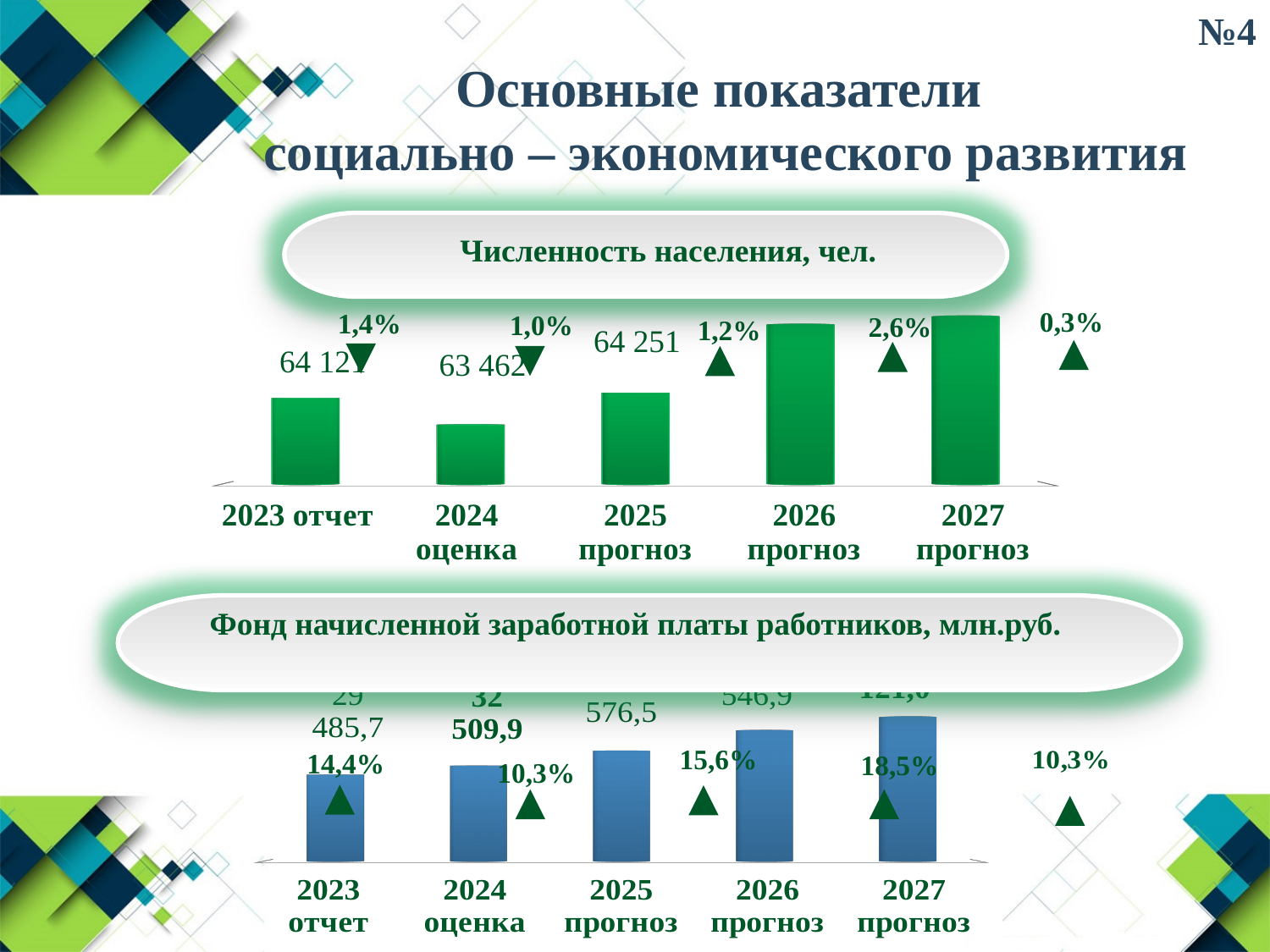
In the 'Фонд начисленной заработной платы работников, млн.руб.' chart, what is the difference between the values for 2024 оценка and 2023 отчет? 3 024,2 In the 'Численность населения, чел.' chart, which category has the highest bar? 2027 прогноз In the 'Фонд начисленной заработной платы работников, млн.руб.' chart, what percentage is printed above the 2027 прогноз bar? 10,3% In the 'Фонд начисленной заработной платы работников, млн.руб.' chart, what is the value for 2024 оценка? 32 509,9 In the 'Численность населения, чел.' chart, how many categories are shown on the x axis? 5 In the 'Численность населения, чел.' chart, which is larger: the value for 2025 прогноз or 2026 прогноз? 2026 прогноз In the 'Численность населения, чел.' chart, what percentage is printed above the 2026 прогноз bar? 2,6% In the 'Численность населения, чел.' chart, which category has the lowest bar? 2024 оценка In the 'Численность населения, чел.' chart, what is the value for 2025 прогноз? 64 251 In the 'Фонд начисленной заработной платы работников, млн.руб.' chart, do the bars rise or fall from 2023 to 2027? rise In the 'Фонд начисленной заработной платы работников, млн.руб.' chart, what is the value for 2023 отчет? 29 485,7 What kind of chart is used for 'Численность населения, чел.'? bar chart